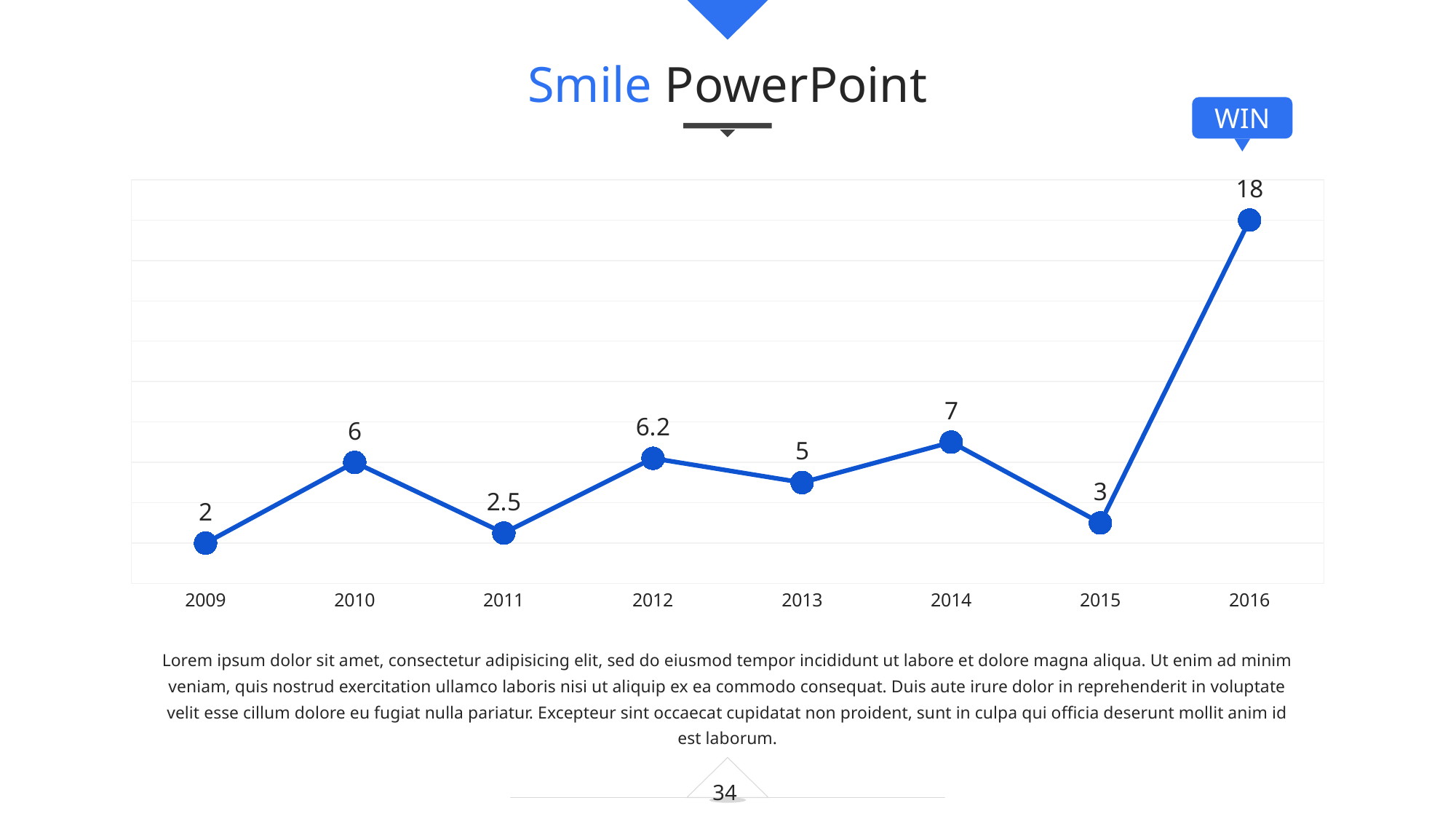
What is the difference between the values for 2016 and 2015? 15 Does the value rise or fall from 2015 to 2016? rise How many years are plotted on the x axis? 8 What is the value for 2012? 6.2 What is the difference between the values for 2010 and 2011? 3.5 What does the label above the 2016 data point say? WIN Which year has the highest value? 2016 What kind of chart is shown on the slide? line chart What is the value for 2016? 18 Which year has the lowest value? 2009 Which is larger, the value for 2014 or the value for 2013? 2014 What is the value for 2011? 2.5